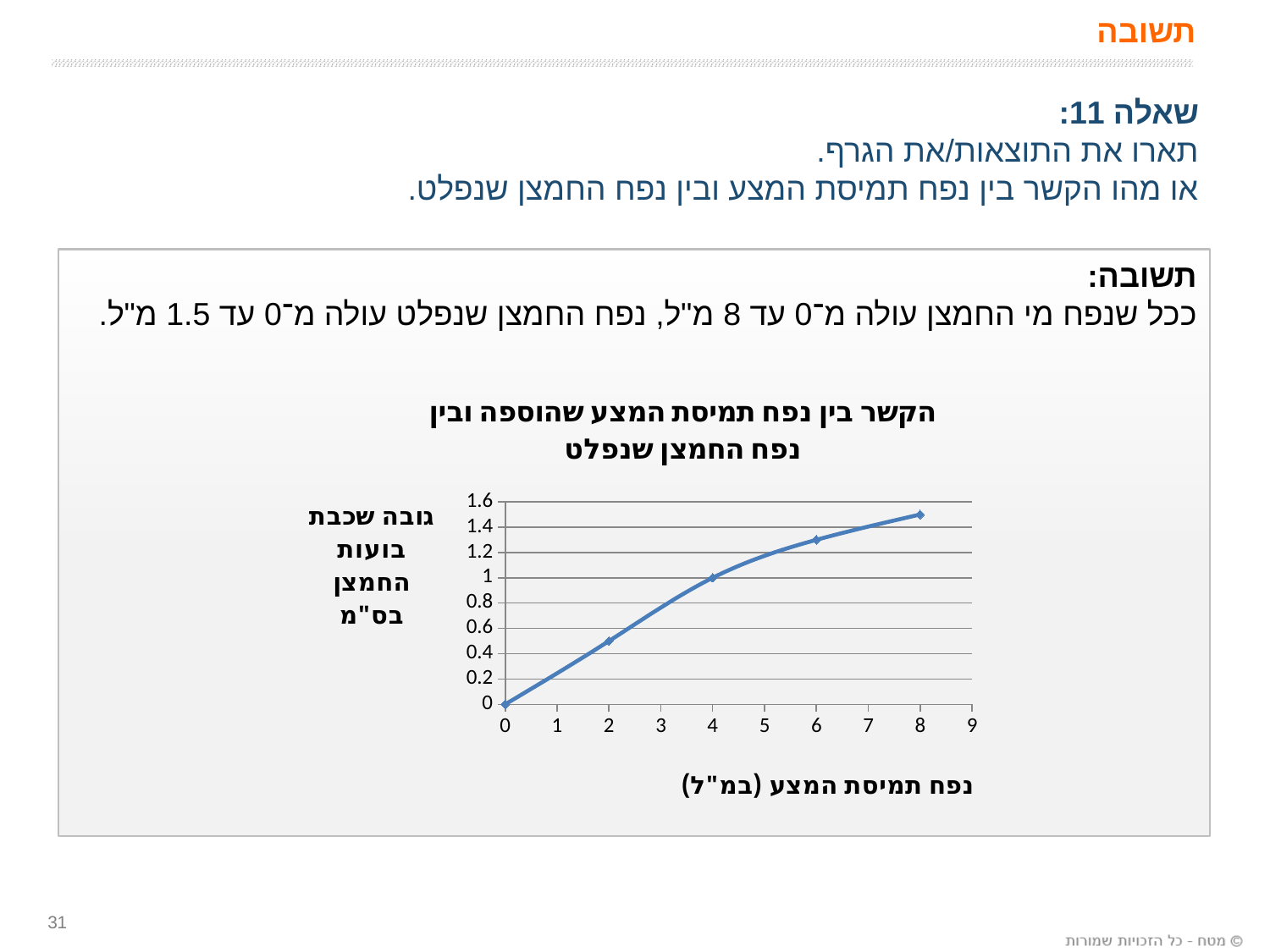
How many data points are plotted on the line? 5 Is the value at x = 2 greater or less than 1? less Which has the larger value: x = 6 or x = 2? x = 6 What is the label of the x axis? נפח תמיסת המצע (במ"ל) At which x value (נפח תמיסת המצע) is the plotted value highest? 8 Is the value at x = 8 greater or less than 1? greater What is the difference between the value at x = 4 and the value at x = 0? 1 What is the y value at x = 4 (נפח תמיסת המצע = 4)? 1 Do the values rise or fall as נפח תמיסת המצע increases along the x axis? rise What kind of chart is shown on the slide? line chart What is the y value at x = 0 (נפח תמיסת המצע = 0)? 0 At which x value (נפח תמיסת המצע) is the plotted value lowest? 0